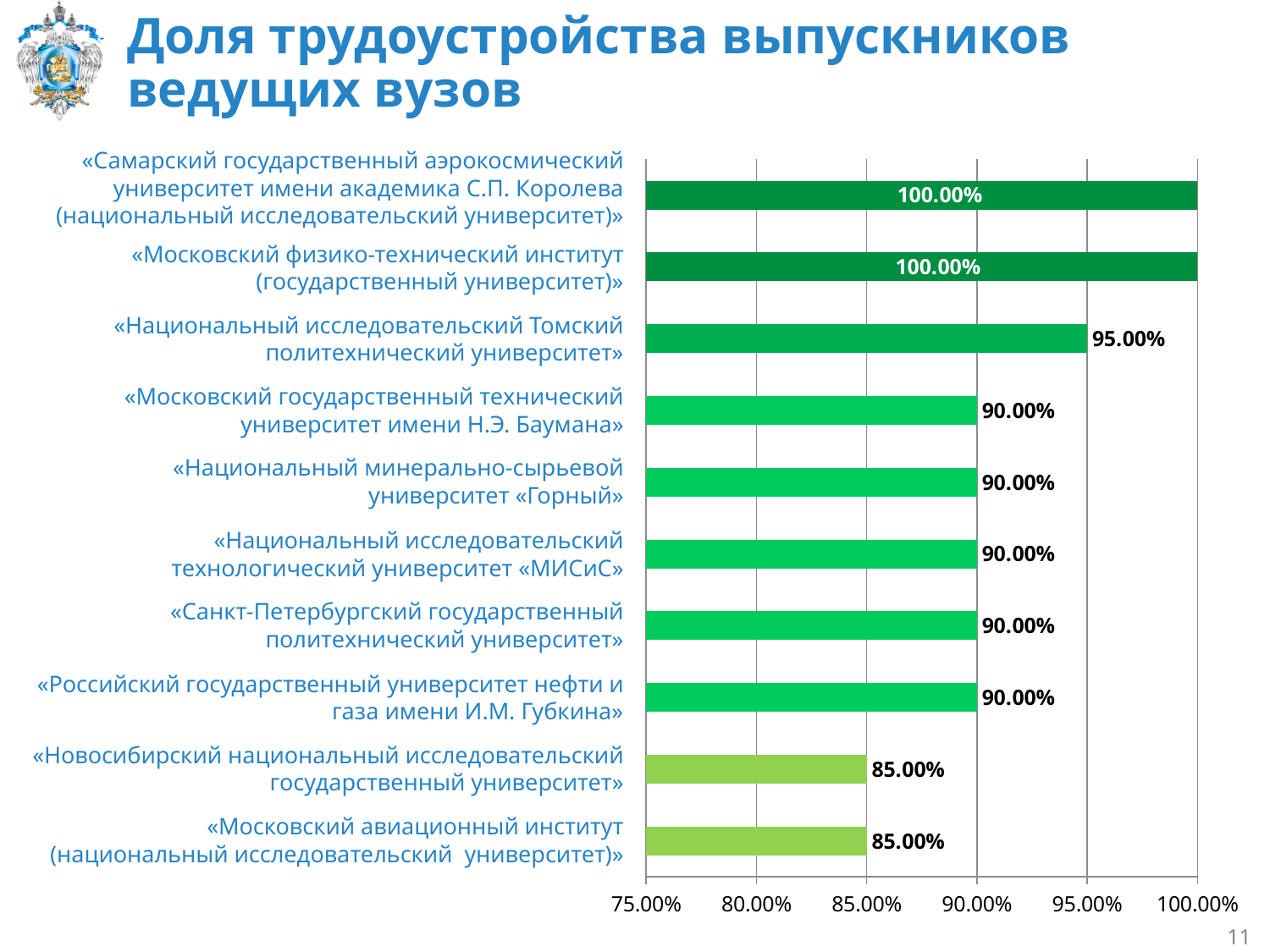
What is the employment share for «Российский государственный университет нефти и газа имени И.М. Губкина»? 90.00% How many universities are shown on the chart? 10 Which has a higher employment share: «Национальный исследовательский Томский политехнический университет» or «Московский авиационный институт (национальный исследовательский университет)»? «Национальный исследовательский Томский политехнический университет» What is the lowest employment share shown on the chart? 85.00% What is the employment share for «Национальный исследовательский Томский политехнический университет»? 95.00% What is the employment share for «Новосибирский национальный исследовательский государственный университет»? 85.00% Is the value for «Новосибирский национальный исследовательский государственный университет» greater or less than 90.00%? less What is the difference between the employment share of «Национальный исследовательский Томский политехнический университет» and «Московский государственный технический университет имени Н.Э. Баумана»? 5.00% What is the highest employment share shown on the chart? 100.00% How many universities on the chart have an employment share of 90.00%? 5 What kind of chart is shown on the slide? bar chart What is the employment share for «Московский физико-технический институт (государственный университет)»? 100.00%